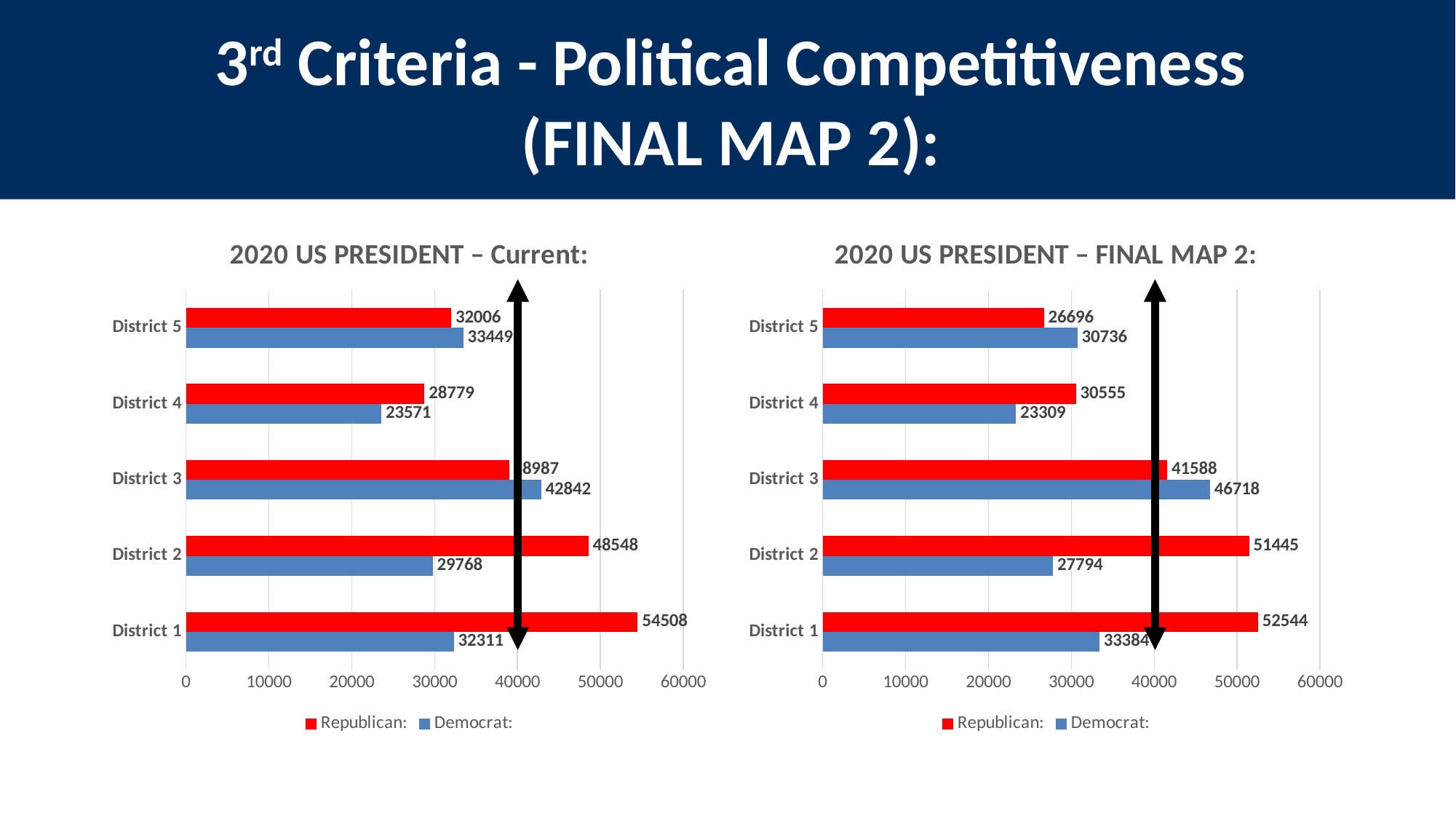
In the '2020 US PRESIDENT – Current' chart, which district has the highest Republican value? District 1 In the '2020 US PRESIDENT – Current' chart, what is the Republican value for District 1? 54508 In the '2020 US PRESIDENT – FINAL MAP 2' chart, which district has the lowest Democrat value? District 4 How many districts are shown in the '2020 US PRESIDENT – Current' chart? 5 In the '2020 US PRESIDENT – FINAL MAP 2' chart, what is the Democrat value for District 3? 46718 In the '2020 US PRESIDENT – FINAL MAP 2' chart, what is the difference between the Republican and Democrat values for District 1? 19160 In the '2020 US PRESIDENT – FINAL MAP 2' chart, what is the Republican value for District 5? 26696 What type of chart is the '2020 US PRESIDENT – Current' chart? Bar chart How many series does the legend of the '2020 US PRESIDENT – FINAL MAP 2' chart list? 2 In the '2020 US PRESIDENT – FINAL MAP 2' chart, is the Republican value for District 2 greater or less than 50000? greater In the '2020 US PRESIDENT – Current' chart, what is the difference between the Republican and Democrat values for District 2? 18780 In the '2020 US PRESIDENT – Current' chart, is the Democrat value for District 5 larger or smaller than the Republican value for District 5? larger